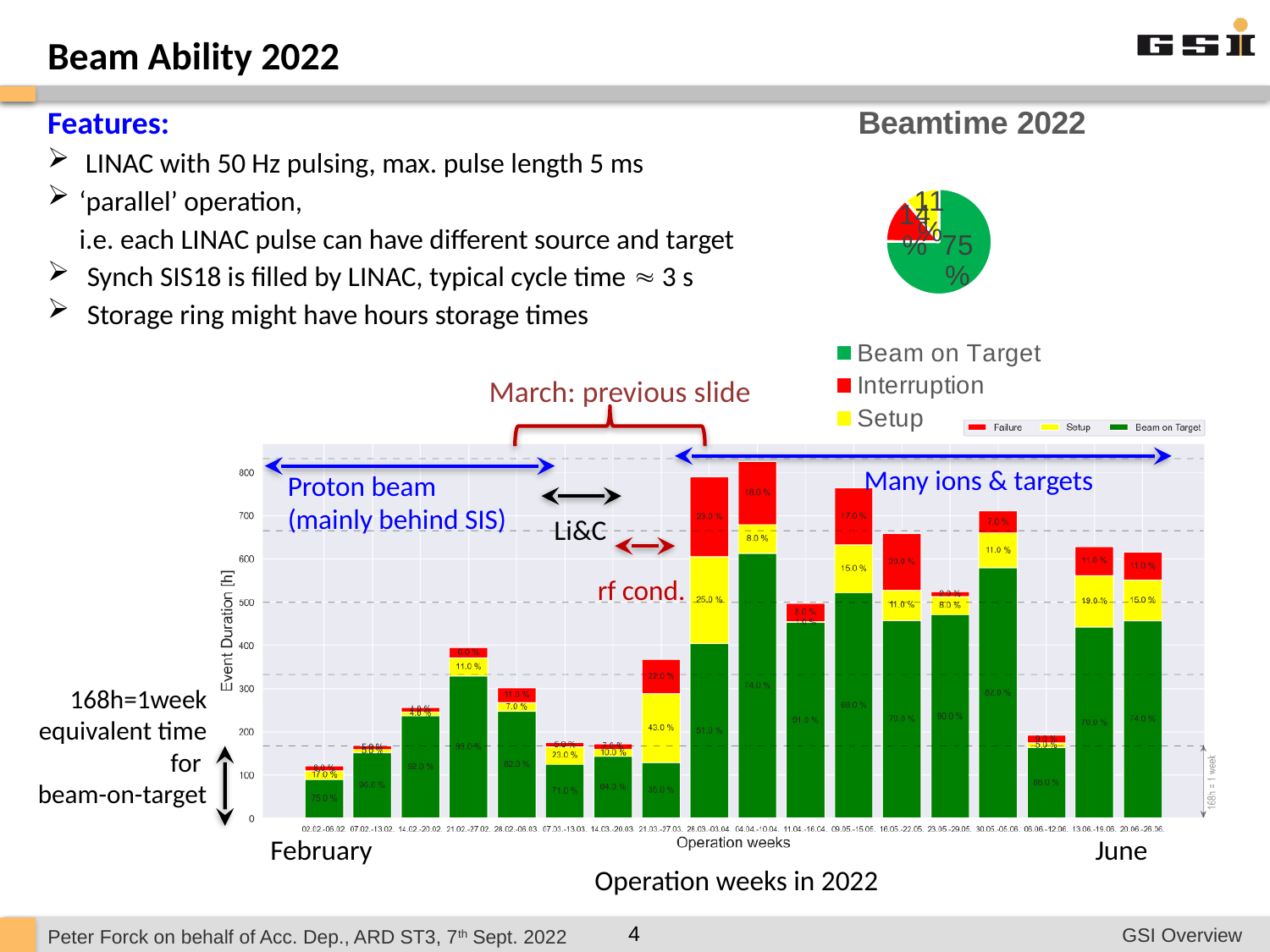
How many operation weeks (bars) are shown in the operation-weeks bar chart? 18 What kind of chart is the 'Beamtime 2022' chart at the top right of the slide? pie chart What is the y-axis label of the operation-weeks bar chart? Event Duration [h] How many categories does the legend of the 'Beamtime 2022' pie chart list? 3 In the operation-weeks bar chart, is the total height of the first bar (leftmost, February) greater or less than 200? less What kind of chart is the large chart of operation weeks at the bottom of the slide? stacked bar chart How many series does the legend of the operation-weeks bar chart list? 3 In the 'Beamtime 2022' pie chart, what share of the beamtime is 'Beam on Target'? 75 % In the 'Beamtime 2022' pie chart, which category has the largest slice? Beam on Target In the operation-weeks bar chart, which series is shown in yellow according to the legend? Setup In the operation-weeks bar chart, is the total height of the tallest bar greater or less than 800? greater